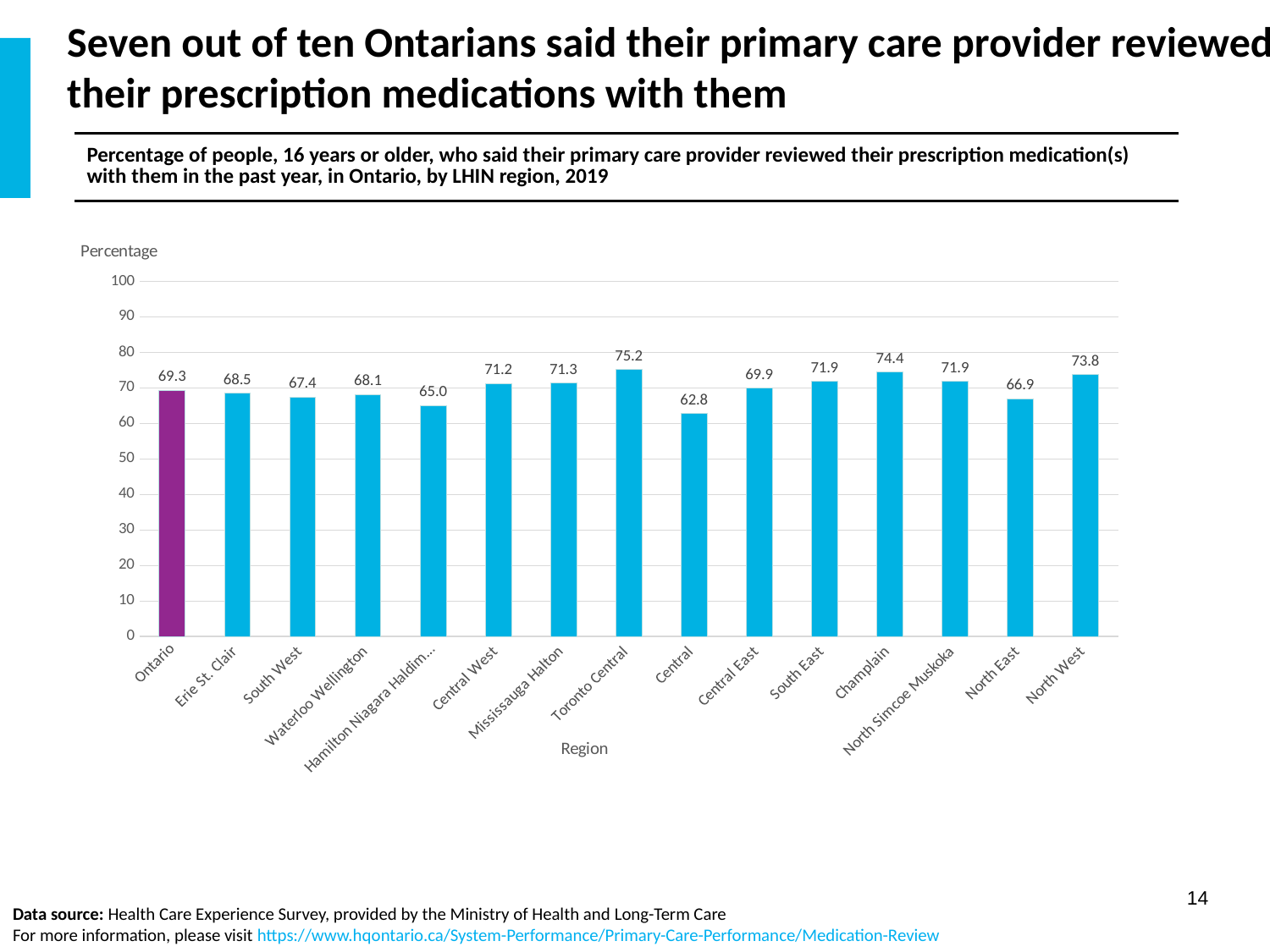
How many bars are shown in the chart? 15 Which region has the lowest value? Central What is the value for North West? 73.8 What is the value for Ontario? 69.3 What is the difference between the values for Champlain and Ontario? 5.1 What is the difference between the values for Toronto Central and Central? 12.4 What kind of chart is shown on the slide? bar chart What is the value for Central East? 69.9 Is the value for Central greater or less than 70? less What is the value for Toronto Central? 75.2 Which is larger, the value for North East or the value for South East? South East Which region has the highest value? Toronto Central